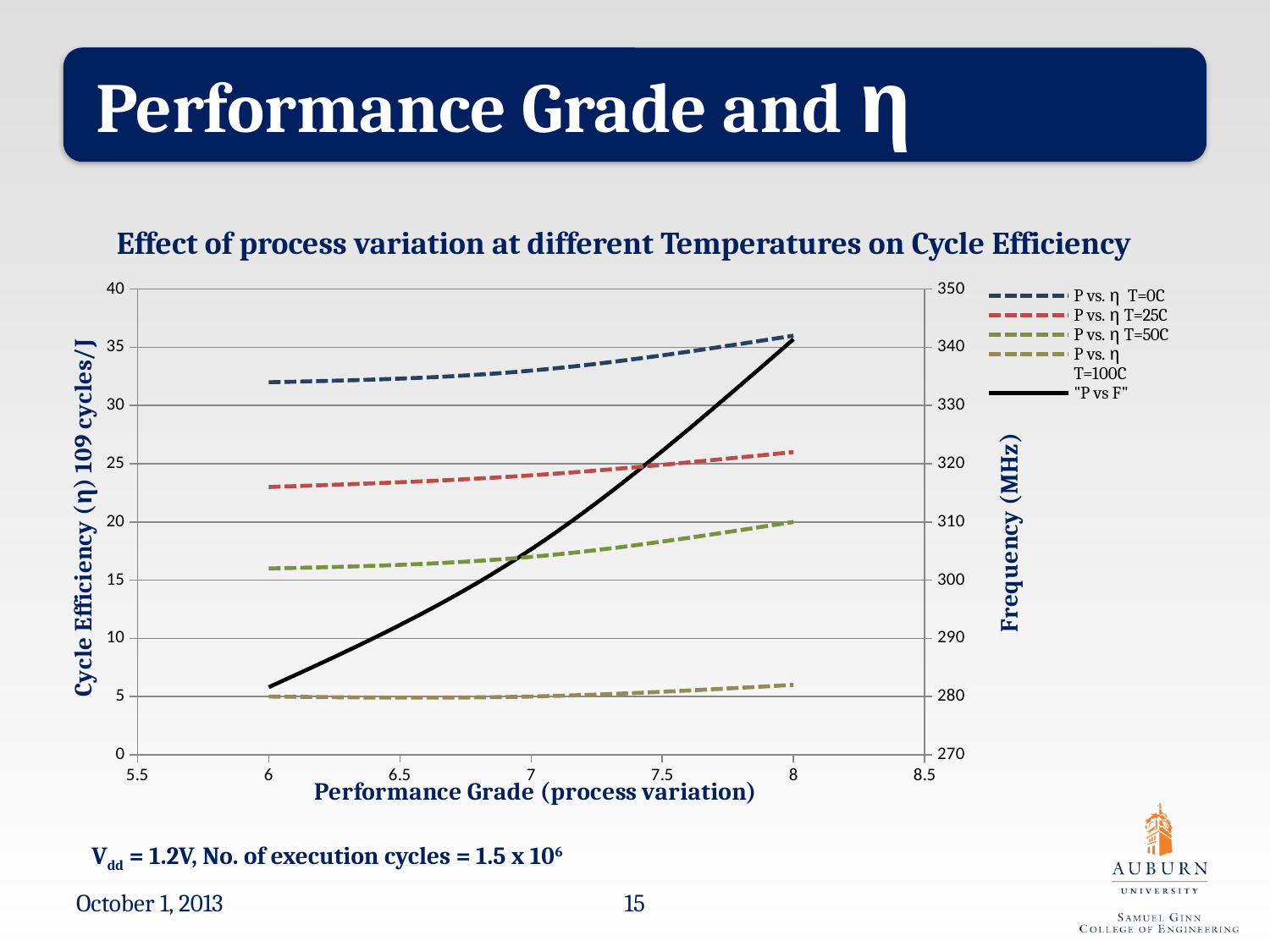
What is the label of the right-hand vertical axis? Frequency (MHz) What kind of chart is shown on the slide? line chart Is the cycle efficiency for P vs. η T=0C at performance grade 6 greater or less than 30? greater Is the cycle efficiency for P vs. η T=100C at performance grade 8 greater or less than 10? less What is the title of the chart? Effect of process variation at different Temperatures on Cycle Efficiency Does the "P vs F" line rise or fall as performance grade increases from 6 to 8? rises At performance grade 8, which has the higher cycle efficiency: P vs. η T=25C or P vs. η T=50C? P vs. η T=25C Which of the P vs. η temperature series has the lowest cycle efficiency across the plotted range? P vs. η T=100C Does the P vs. η T=0C line rise or fall as performance grade increases from 6 to 8? rises Is the cycle efficiency for P vs. η T=50C at performance grade 6 greater or less than 20? less How many series does the legend list? 5 Which of the P vs. η temperature series has the highest cycle efficiency across the plotted range? P vs. η T=0C